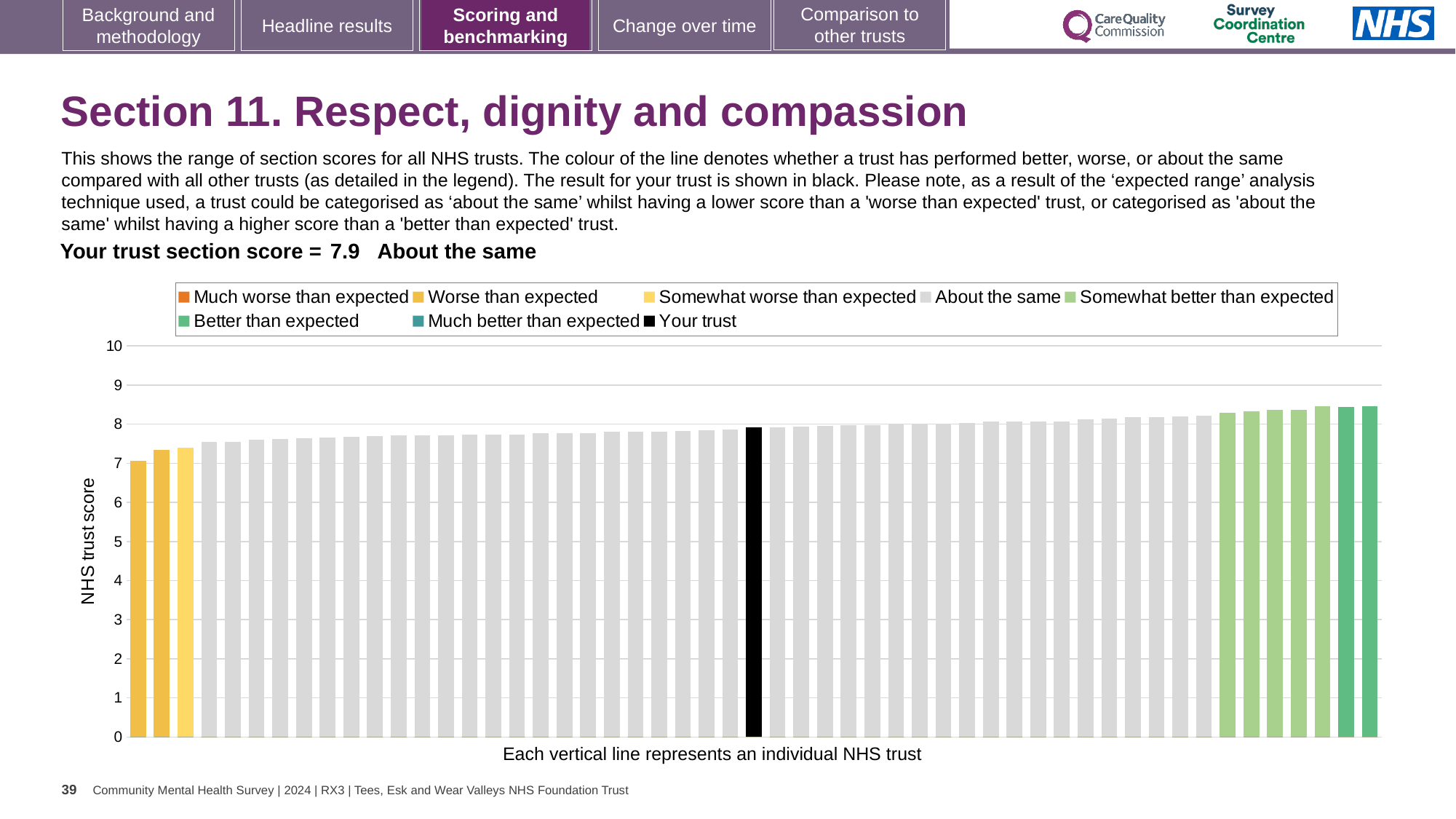
What is the section score for your trust shown on the slide? 7.9 Is the value of the lowest bar greater or less than 8? less Do the bar values rise or fall from left to right across the chart? rise Is the value of the highest bar greater or less than 8? greater Is the value of the highest bar greater or less than 9? less What is the label on the vertical axis of the chart? NHS trust score Is the bar for your trust higher or lower than the highest bar on the chart? lower Which performance category is your trust placed in for Section 11? About the same How many entries does the chart legend list? 8 What kind of chart is shown on the slide? Bar chart How many bars are shown in the 'Worse than expected' colour? 2